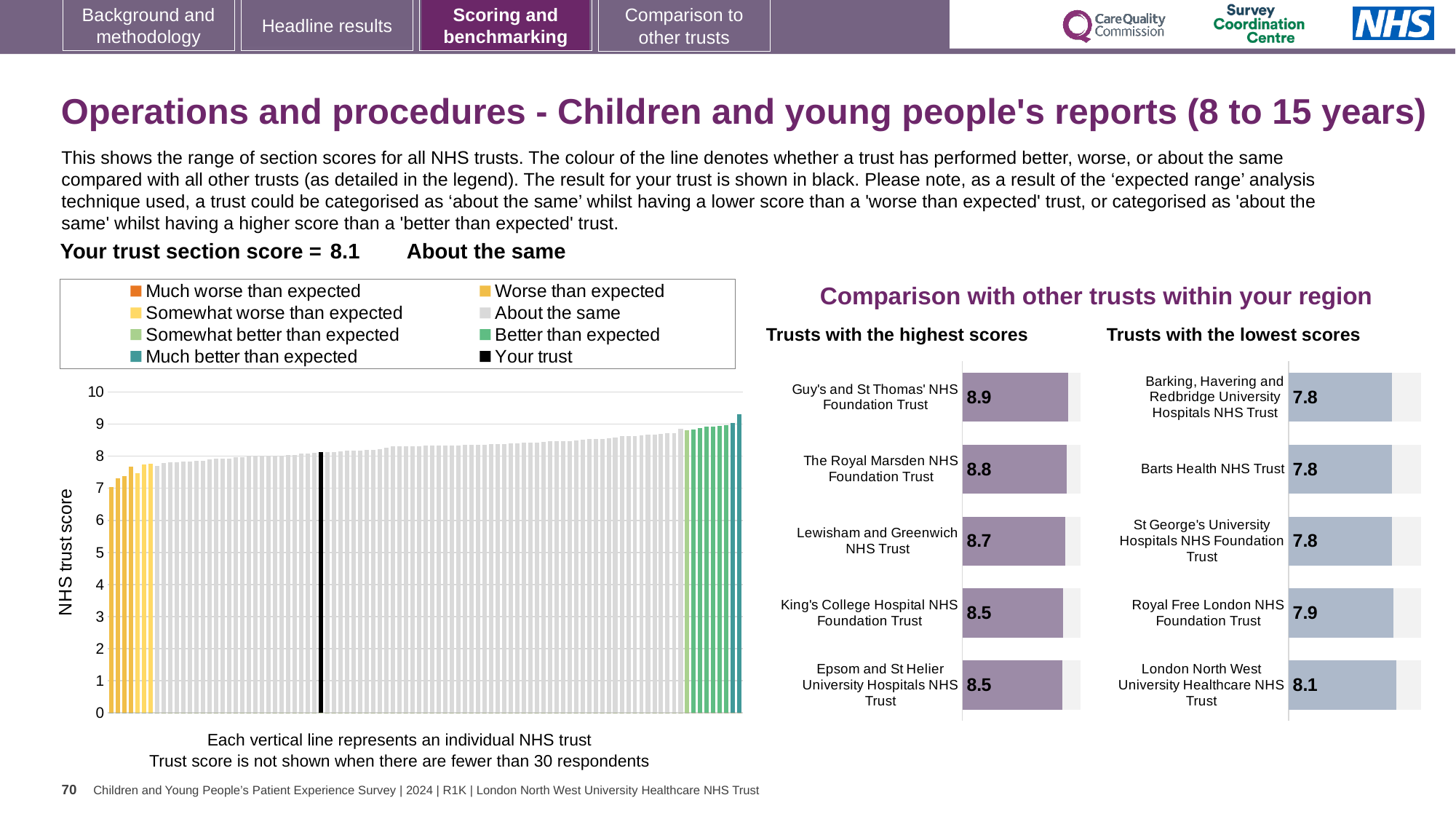
In the 'Trusts with the lowest scores' chart, which has the larger score: Royal Free London NHS Foundation Trust or Barts Health NHS Trust? Royal Free London NHS Foundation Trust In the 'Trusts with the lowest scores' chart, what is the difference between the scores of London North West University Healthcare NHS Trust and Barts Health NHS Trust? 0.3 How many trusts are shown in the 'Trusts with the highest scores' chart? 5 In the 'Trusts with the lowest scores' chart, what is the score for Royal Free London NHS Foundation Trust? 7.9 In the 'Trusts with the highest scores' chart, which trust has the highest score? Guy's and St Thomas' NHS Foundation Trust In the 'Trusts with the lowest scores' chart, what is the score for London North West University Healthcare NHS Trust? 8.1 What kind of chart is the large chart on the left showing NHS trust scores? Bar chart In the 'Trusts with the highest scores' chart, what is the score for Guy's and St Thomas' NHS Foundation Trust? 8.9 In the large chart on the left, do the NHS trust scores rise or fall from left to right? Rise In the 'Trusts with the lowest scores' chart, which trust has the highest score? London North West University Healthcare NHS Trust In the 'Trusts with the highest scores' chart, what is the score for Lewisham and Greenwich NHS Trust? 8.7 In the 'Trusts with the highest scores' chart, what is the difference between the scores of Guy's and St Thomas' NHS Foundation Trust and King's College Hospital NHS Foundation Trust? 0.4